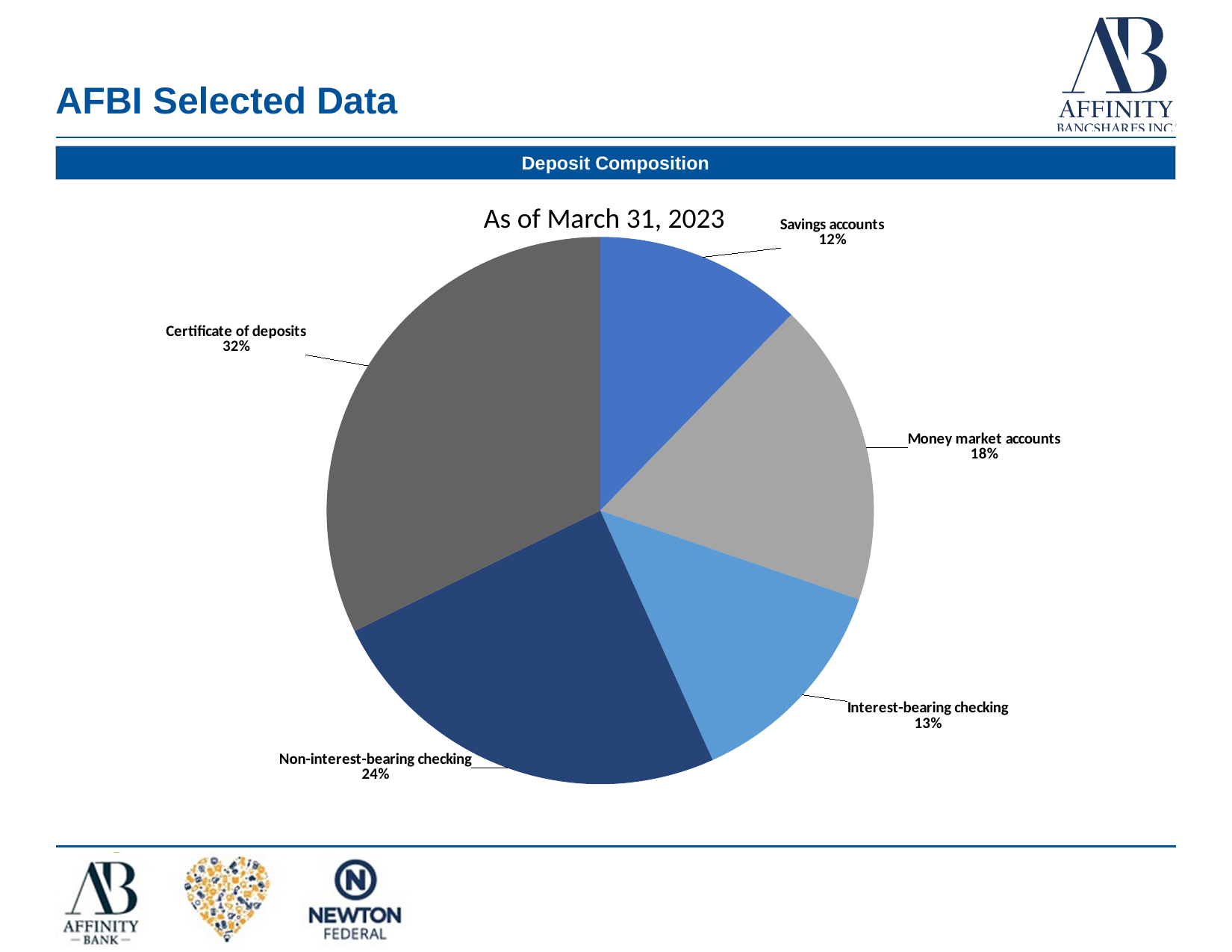
What share of deposits is Savings accounts? 12% Which deposit category has the smallest share? Savings accounts What share of deposits is Certificate of deposits? 32% What is the difference in percentage points between Certificate of deposits and Non-interest-bearing checking? 8 What share of deposits is Money market accounts? 18% What kind of chart is shown on the slide? Pie chart What share of deposits is Interest-bearing checking? 13% How many deposit categories are shown in the pie chart? 5 Which is larger, Money market accounts or Interest-bearing checking? Money market accounts What share of deposits is Non-interest-bearing checking? 24% As of what date is the deposit composition shown? March 31, 2023 Which deposit category has the largest share? Certificate of deposits